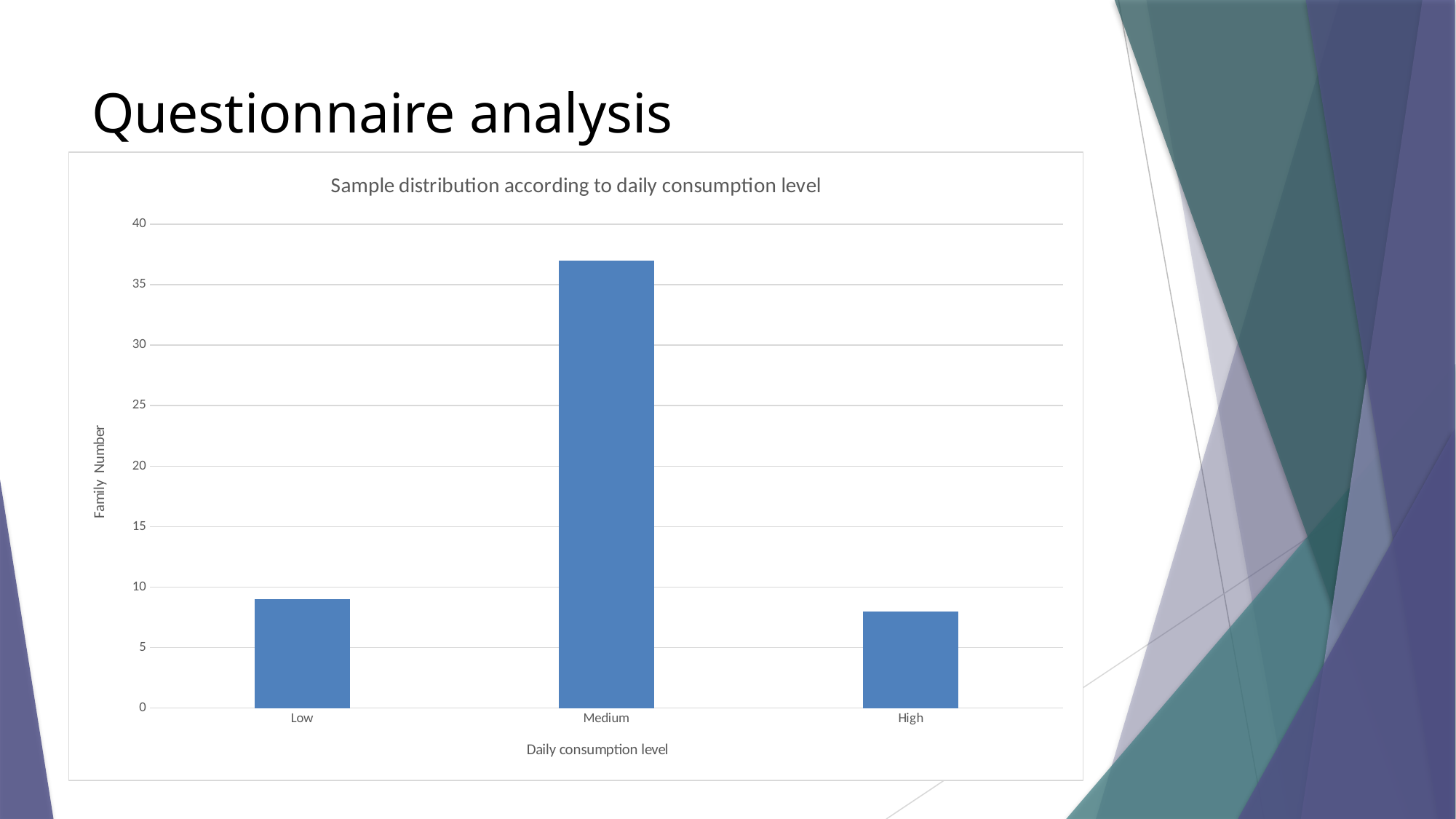
Is the value for Low greater or less than 10? less Which is larger, the value for High or the value for Medium? Medium Is the value for Medium greater or less than 35? greater Which daily consumption level has the highest family number? Medium What is the label of the vertical axis? Family Number Is the value for High greater or less than 5? greater Which is larger, the value for Medium or the value for Low? Medium What is the title of the chart? Sample distribution according to daily consumption level What kind of chart is shown on the slide? bar chart How many daily consumption level categories are shown on the x axis? 3